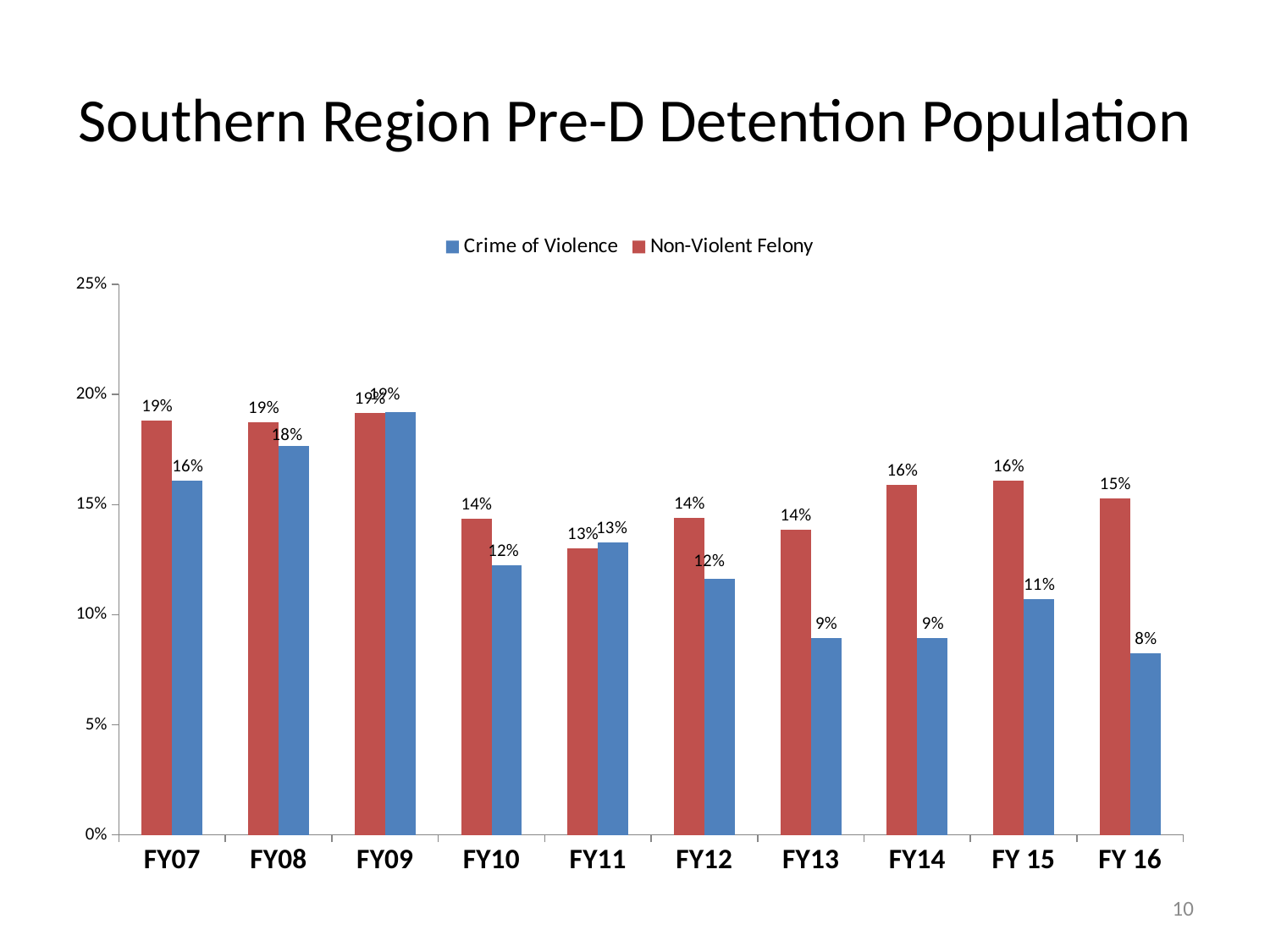
In which fiscal year is the Crime of Violence value lowest? FY 16 How many series does the legend list? 2 Does the Crime of Violence value rise or fall from FY09 to FY 16? Fall Which is larger for FY13, the Non-Violent Felony value or the Crime of Violence value? Non-Violent Felony What kind of chart is shown on the slide? Bar chart What is the difference between the Non-Violent Felony and Crime of Violence values for FY14? 7% What is the Non-Violent Felony value for FY14? 16% What is the Non-Violent Felony value for FY07? 19% What is the Crime of Violence value for FY 16? 8% What is the Crime of Violence value for FY 15? 11% Which colour represents the Non-Violent Felony series? Red How many fiscal years are shown on the x axis? 10